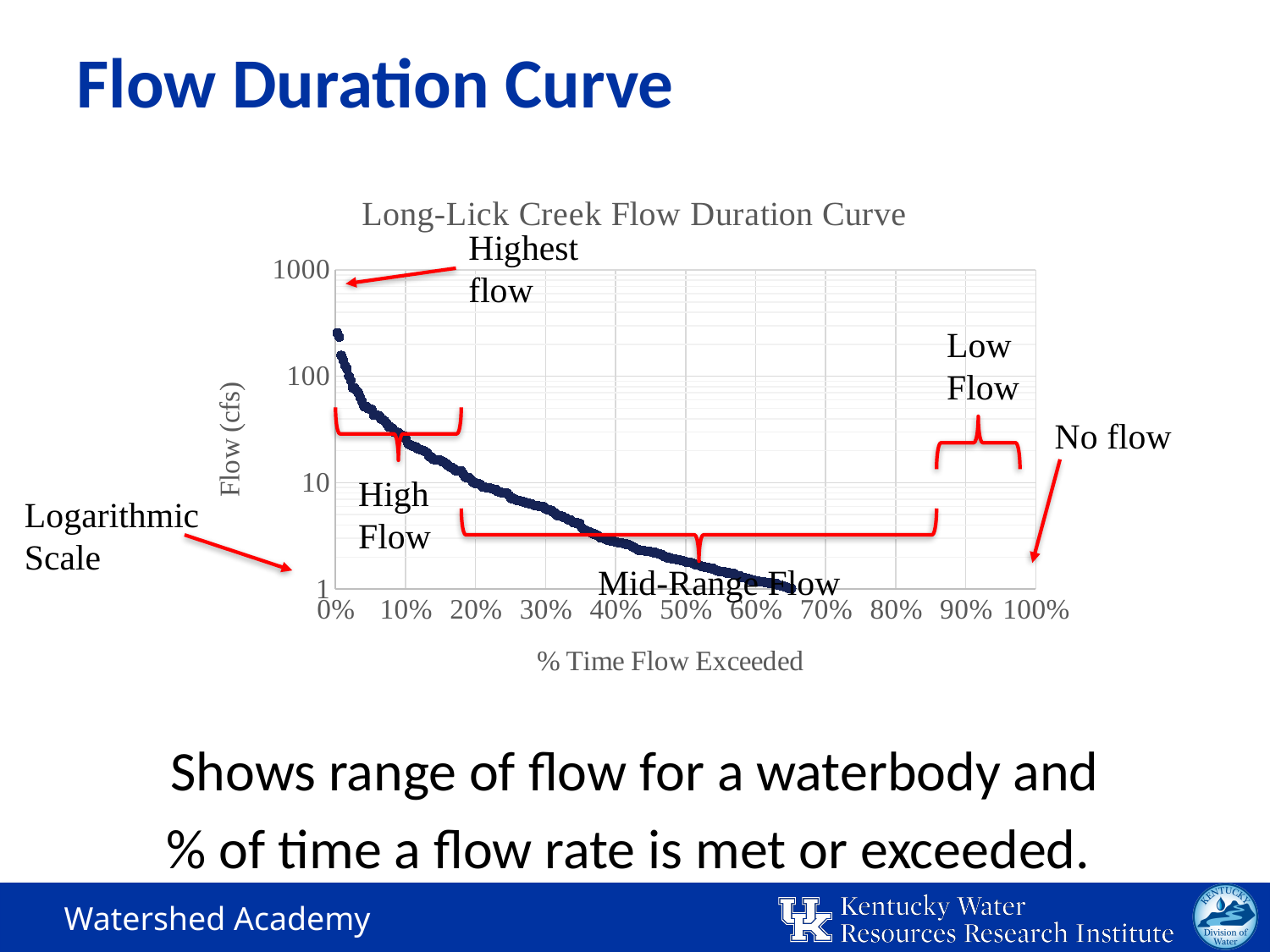
Which has the larger flow value: 0% time exceeded or 30% time exceeded? 0% What is the highest tick value shown on the vertical axis? 1000 Is the flow value at 0% time exceeded greater or less than 100 cfs? greater Is the flow value at 10% time exceeded greater or less than 100 cfs? less What is the title of the chart? Long-Lick Creek Flow Duration Curve What kind of chart is shown on the slide? scatter chart What kind of scale is used on the vertical axis of the chart? Logarithmic Is the flow value at 40% time exceeded greater or less than 10 cfs? less Which has the larger flow value: 10% time exceeded or 50% time exceeded? 10% Do the plotted flow values rise or fall as % Time Flow Exceeded increases? fall